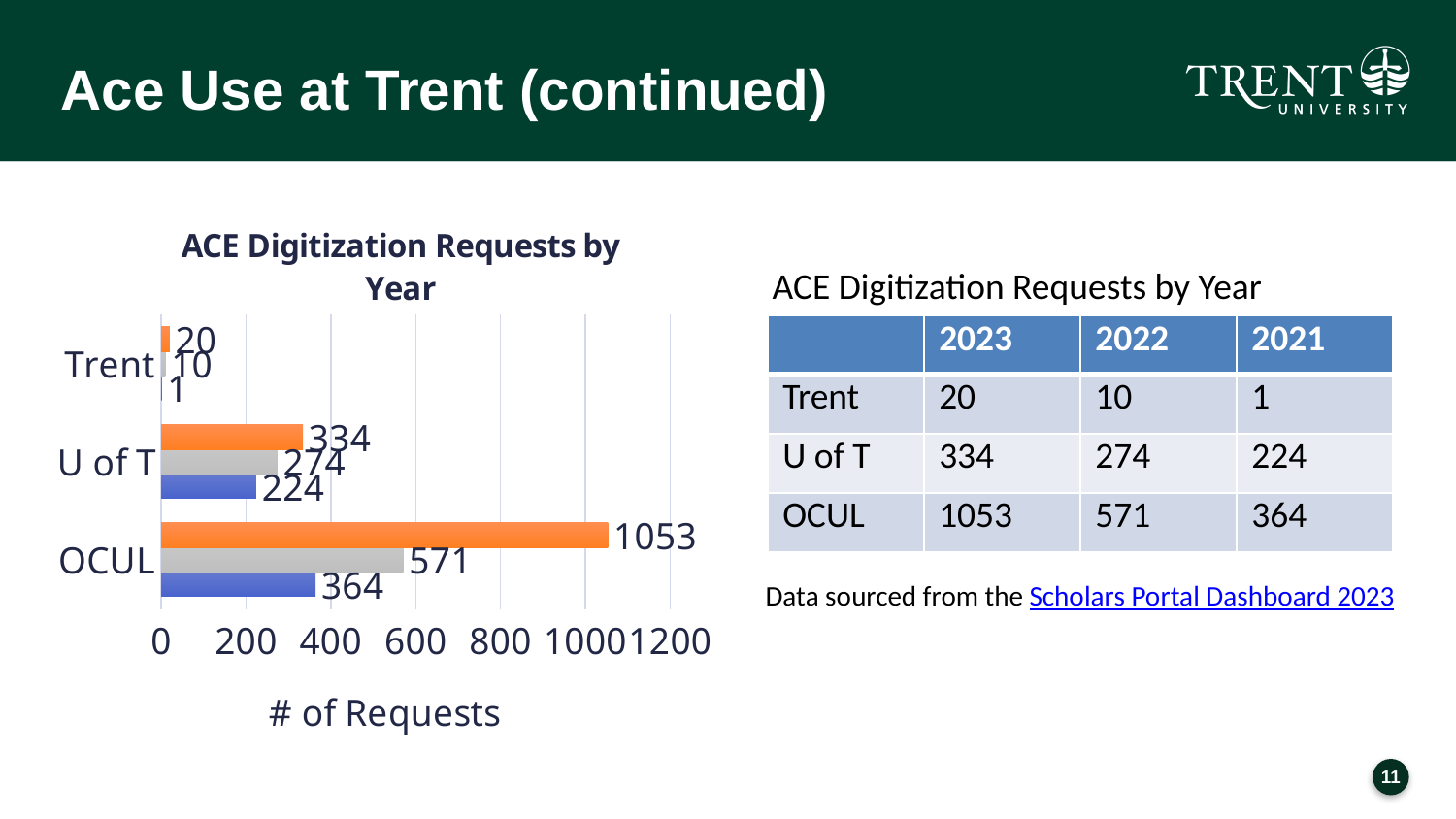
Which institution has the lowest number of requests on the chart? Trent What is the difference between OCUL's largest value (1053) and its smallest value (364)? 689 What is the title of the chart? ACE Digitization Requests by Year Which institution has the highest number of requests on the chart? OCUL What is the value of the longest bar for U of T? 334 What is the x-axis label of the chart? # of Requests Is the value 1053 for OCUL greater or less than 1000? greater What is the highest value shown for OCUL on the chart? 1053 What type of chart is shown on the slide? bar chart What is the smallest value shown for Trent on the chart? 1 Which is larger: U of T's 334 or OCUL's 571? OCUL's 571 How many institutions (categories) are shown on the chart's y-axis? 3